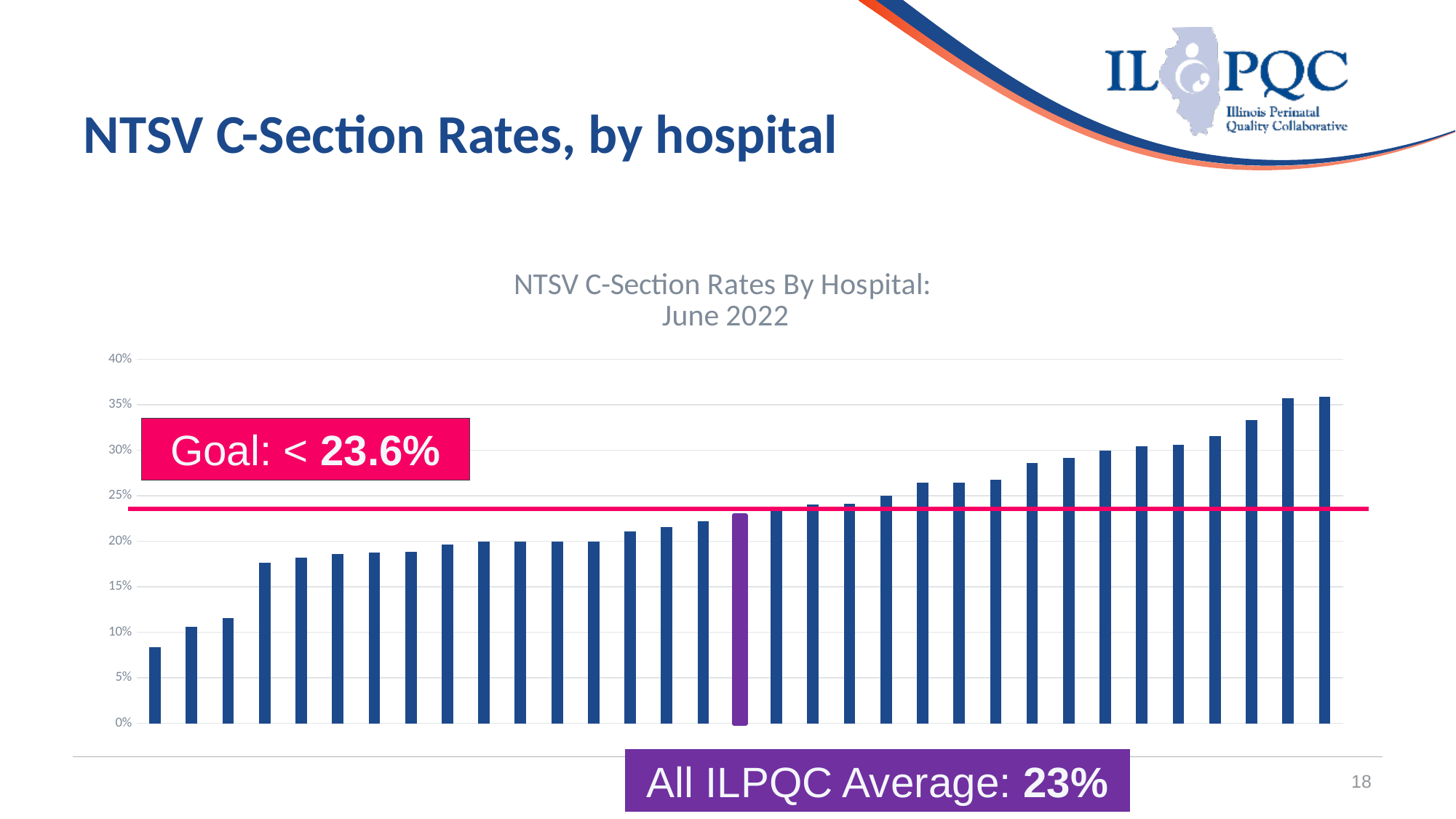
What is the All ILPQC Average NTSV C-section rate shown on the chart? 23% What value does the purple bar on the chart represent? 23% Is the value of the leftmost bar greater or less than 10%? less What is the title of the chart? NTSV C-Section Rates By Hospital: June 2022 Is the value of the rightmost bar greater or less than 35%? greater How many bars are plotted on the chart? 33 Is the value of the fourth bar from the left greater or less than 15%? greater What colour is the bar that represents the All ILPQC Average? Purple Do the bar values rise or fall from left to right across the chart? Rise What kind of chart is shown on the slide? Bar chart Which bar has the lowest value, the leftmost bar or the rightmost bar? The leftmost bar What is the goal NTSV C-section rate shown on the chart? < 23.6%